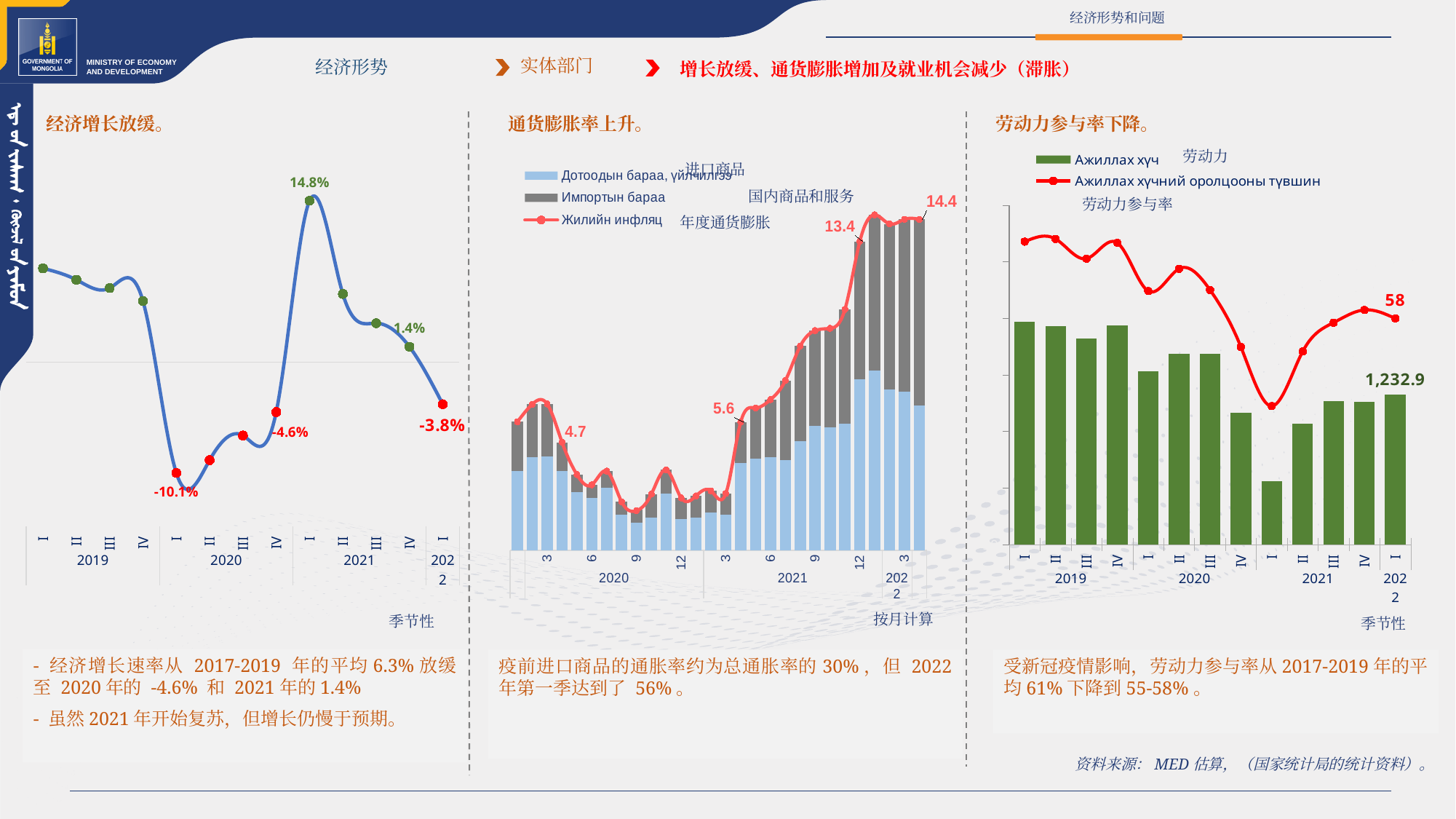
On the right chart (劳动力参与率下降), which quarter has the lowest bar? 2021 I On the left chart (经济增长放缓), what is the value labeled for 2022 I? -3.8% On the middle chart (通货膨胀率上升), how many series does the legend list? 3 On the left chart (经济增长放缓), how many quarterly data points are plotted? 13 On the left chart (经济增长放缓), what kind of chart is it? Line chart On the left chart (经济增长放缓), what is the lowest value labeled on the line? -10.1% On the right chart (劳动力参与率下降), what is the value labeled on the bar for 2022 I? 1,232.9 On the left chart (经济增长放缓), what is the value labeled for 2021 I? 14.8% On the left chart (经济增长放缓), which quarter has the highest value? 2021 I On the middle chart (通货膨胀率上升), what is the highest value labeled on the annual inflation line? 14.4 On the left chart (经济增长放缓), what is the value labeled for 2021 IV? 1.4% On the left chart (经济增长放缓), what is the difference between the 2021 I value and the 2022 I value? 18.6 percentage points